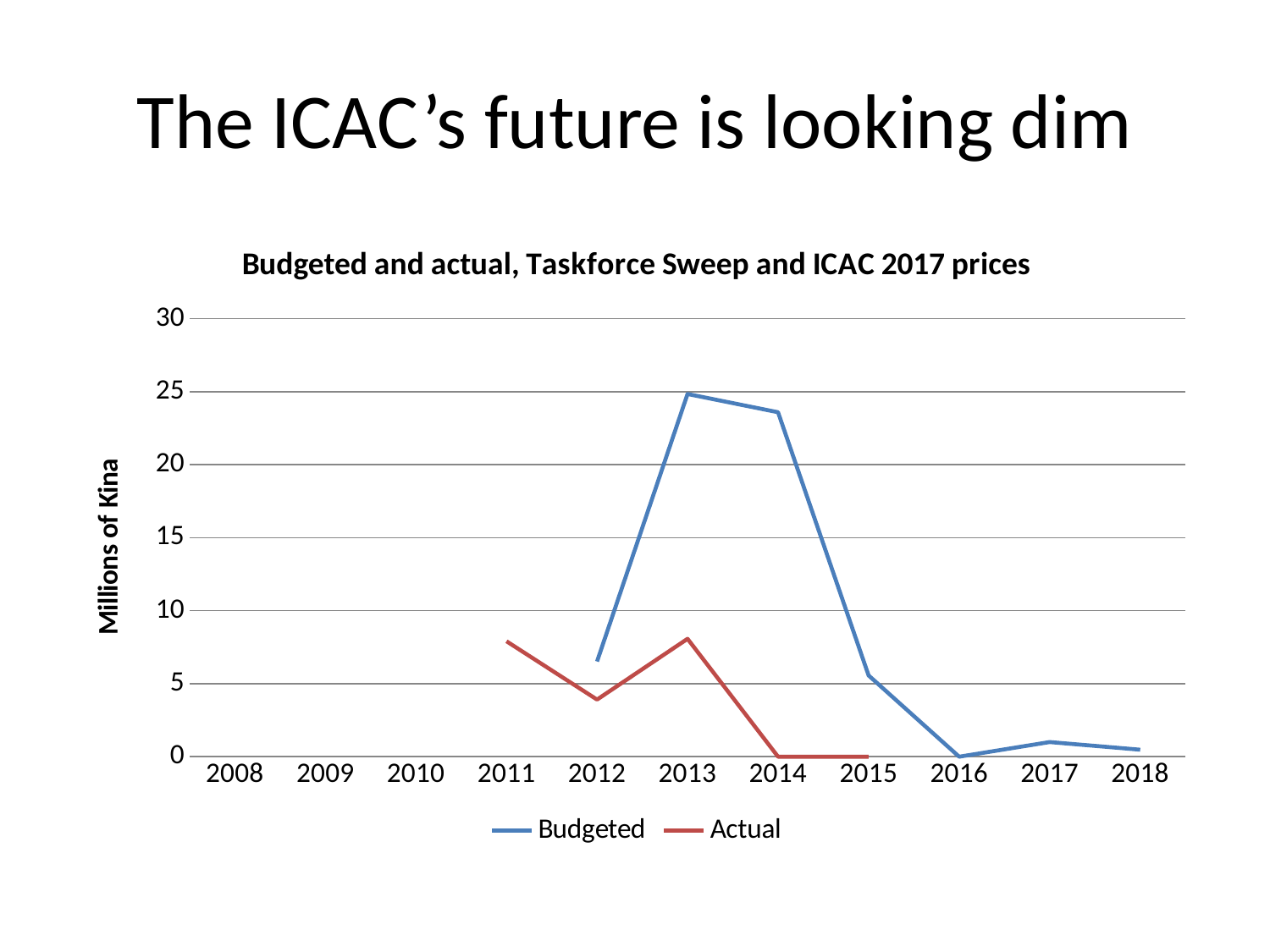
Does the Budgeted series rise or fall from 2013 to 2016? fall How many years are shown on the x axis? 11 Which series has the larger value in 2014, Budgeted or Actual? Budgeted In which year does the Budgeted series reach its highest value? 2013 What kind of chart is shown on the slide? line chart Is the Actual value for 2011 greater or less than 5? greater Is the Budgeted value for 2015 greater or less than 10? less Is the Budgeted value for 2013 greater or less than 20? greater What is the label on the vertical axis? Millions of Kina What is the title of the chart? Budgeted and actual, Taskforce Sweep and ICAC 2017 prices How many series does the legend list? 2